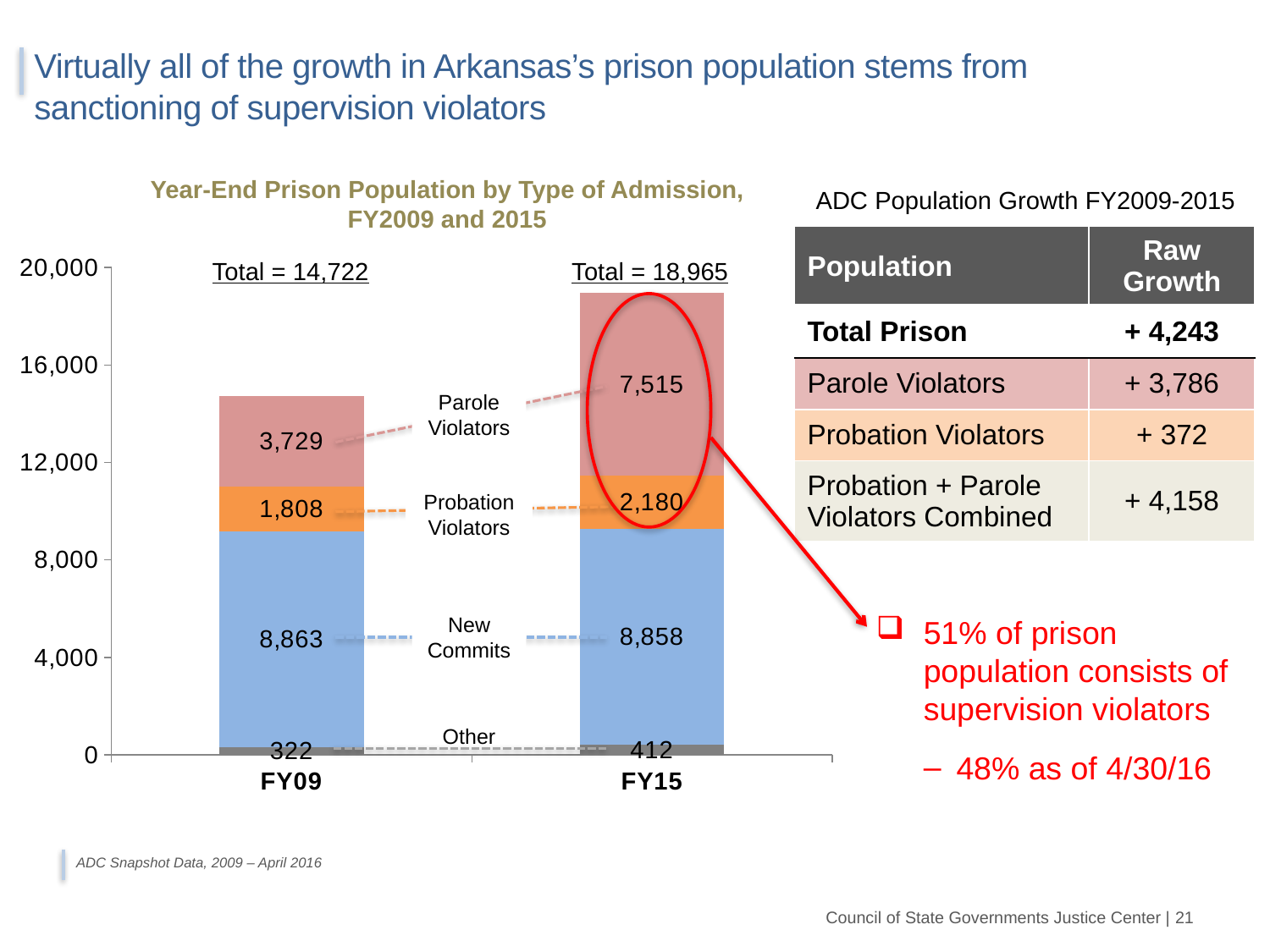
Which segment is the smallest in the FY15 bar? Other What is the total of the FY09 stacked bar? 14,722 Is the value for Probation Violators larger in FY09 or FY15? FY15 What is the value for Parole Violators in FY15? 7,515 What kind of chart is shown on the slide? Stacked bar chart What is the value for Probation Violators in FY15? 2,180 How many categories are shown on the x axis? 2 What is the difference between Parole Violators in FY15 and FY09? 3,786 What is the total of the FY15 stacked bar? 18,965 What is the value for New Commits in FY09? 8,863 Which segment is the largest in the FY09 bar? New Commits What is the value for Other in FY09? 322